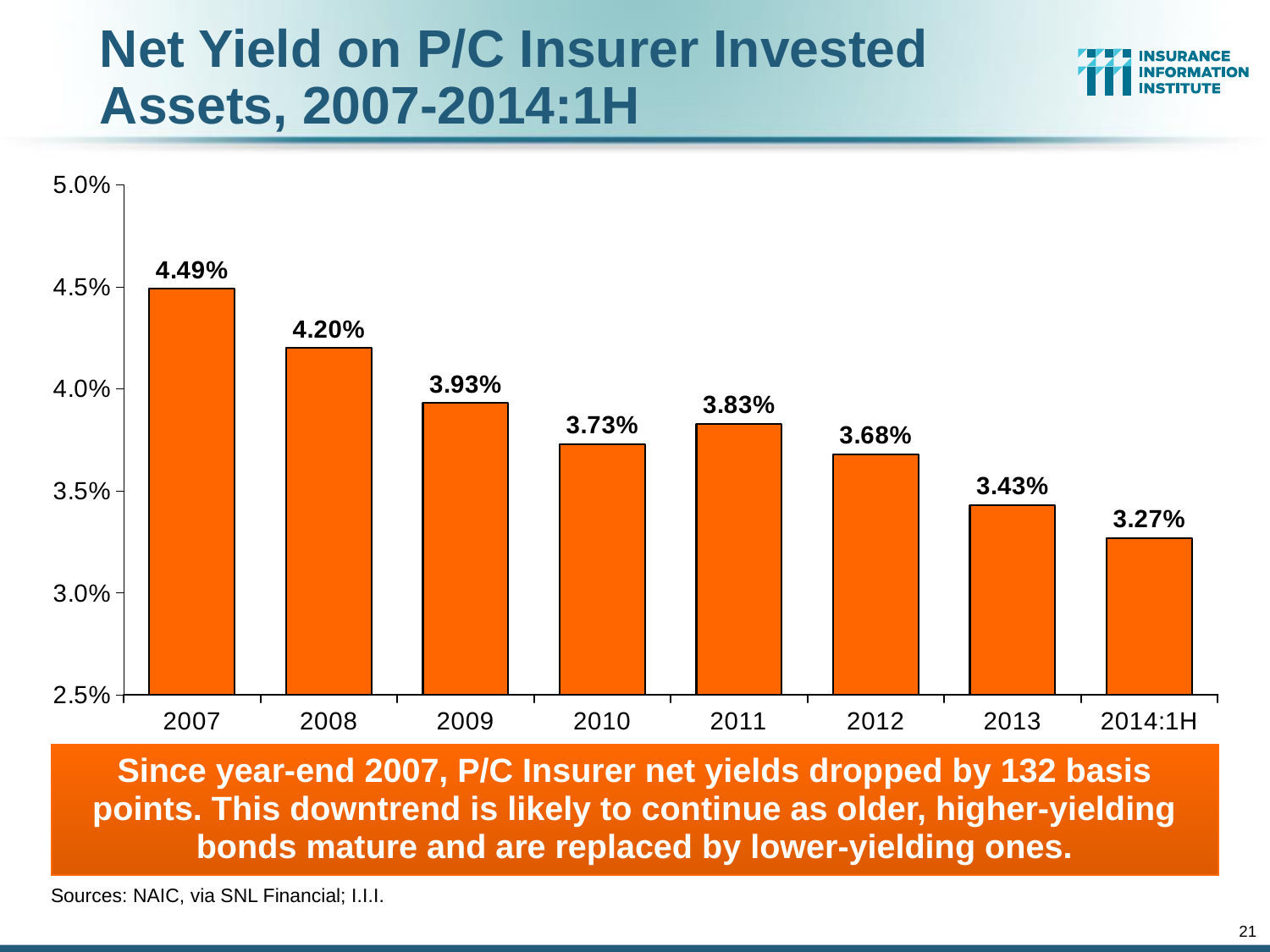
What is the difference in net yield between 2010 and 2011? 0.10% Which year has the highest net yield? 2007 What is the net yield for 2014:1H? 3.27% What is the net yield for 2011? 3.83% How many periods are shown on the x axis? 8 Which period has the lowest net yield? 2014:1H What is the net yield for 2007? 4.49% Is the value for 2013 greater or less than 3.5%? less What kind of chart is shown on the slide? bar chart Do the net yields generally rise or fall from 2007 to 2014:1H? fall Which is larger, the net yield for 2009 or for 2012? 2009 What is the difference in net yield between 2007 and 2008? 0.29%